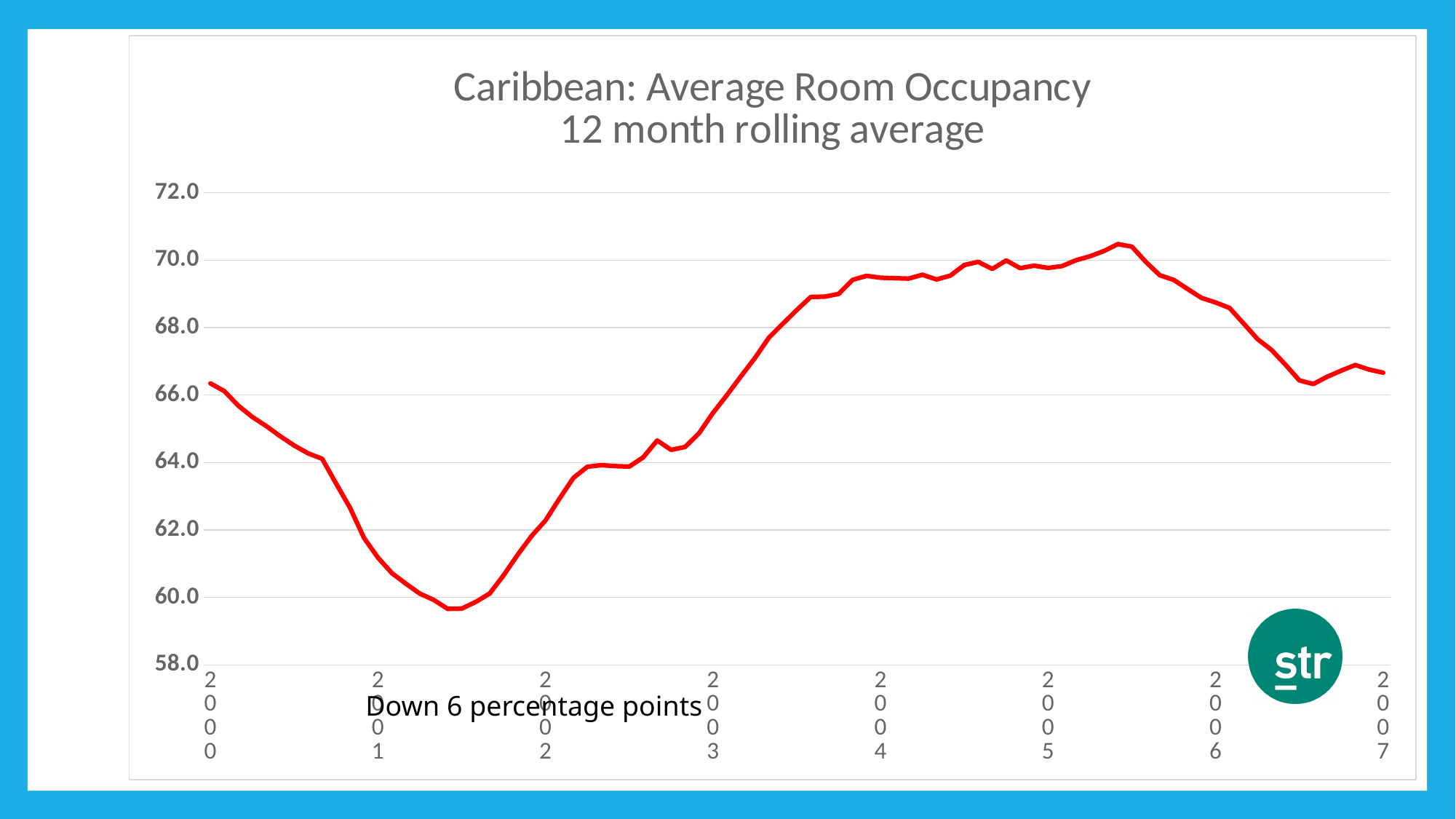
What kind of chart is shown on the slide? line chart Is the value at the start of 2007 greater or less than 68.0? less What is the title of the chart? Caribbean: Average Room Occupancy 12 month rolling average Does the line rise or fall between the start of 2002 and the start of 2004? rise Is the value at the start of 2004 greater or less than 68.0? greater How many years are labelled on the x axis? 8 Does the line rise or fall between the start of 2000 and the start of 2001? fall Is the value at the start of 2005 greater or less than 68.0? greater